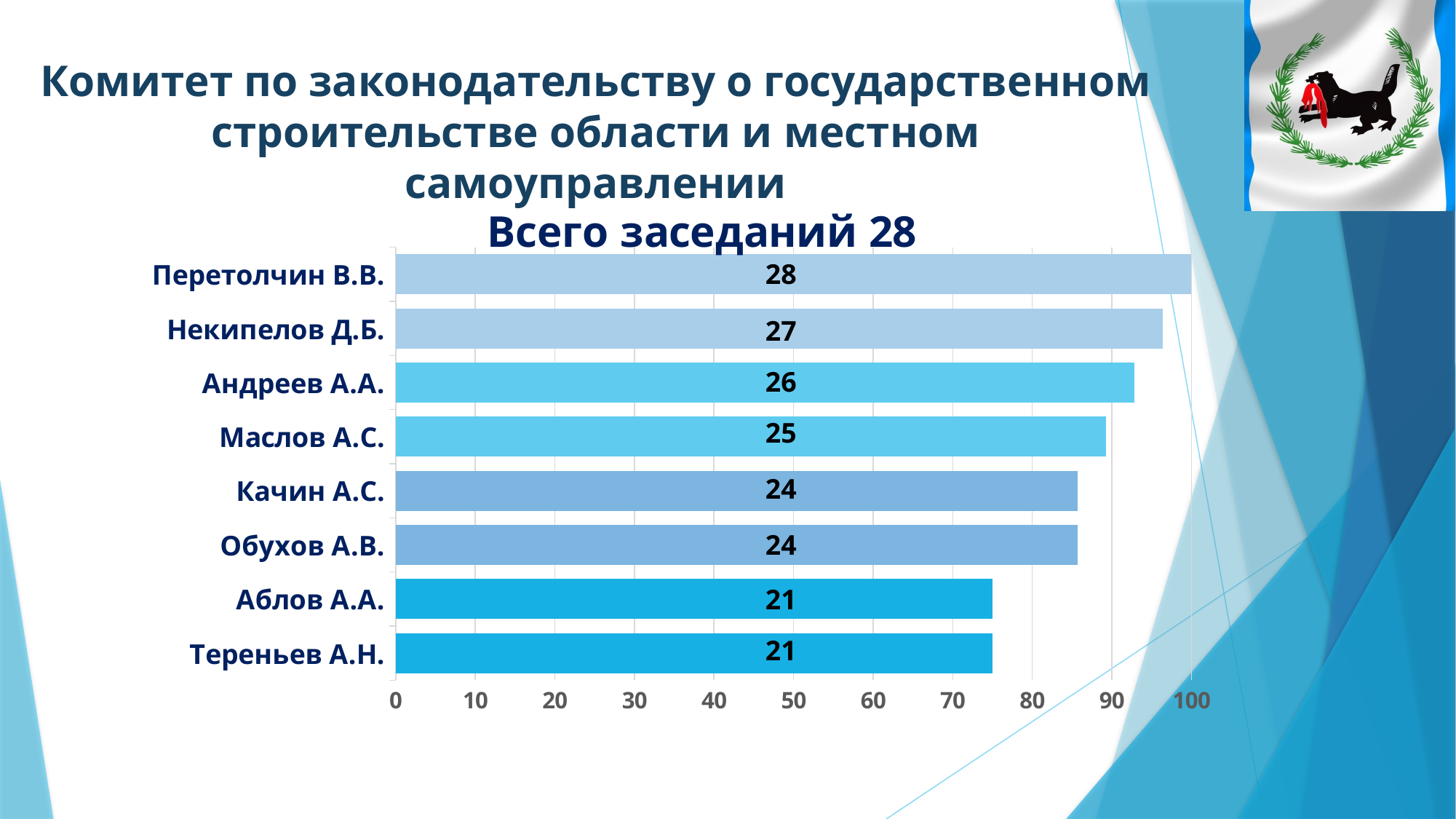
What is the difference between the values for Перетолчин В.В. and Тереньев А.Н.? 7 On the horizontal axis, does the bar for Качин А.С. end at a point greater or less than 80? greater What is the title of the chart? Всего заседаний 28 What kind of chart is shown on the slide? bar chart What is the value shown for Аблов А.А.? 21 What is the value shown for Маслов А.С.? 25 How many categories (deputies) are shown in the chart? 8 On the horizontal axis, does the bar for Аблов А.А. end at a point greater or less than 70? greater What is the value shown for Перетолчин В.В.? 28 Which two categories share the lowest value in the chart? Аблов А.А. and Тереньев А.Н. Which has a larger value, Некипелов Д.Б. or Качин А.С.? Некипелов Д.Б. Which category has the highest value in the chart? Перетолчин В.В.